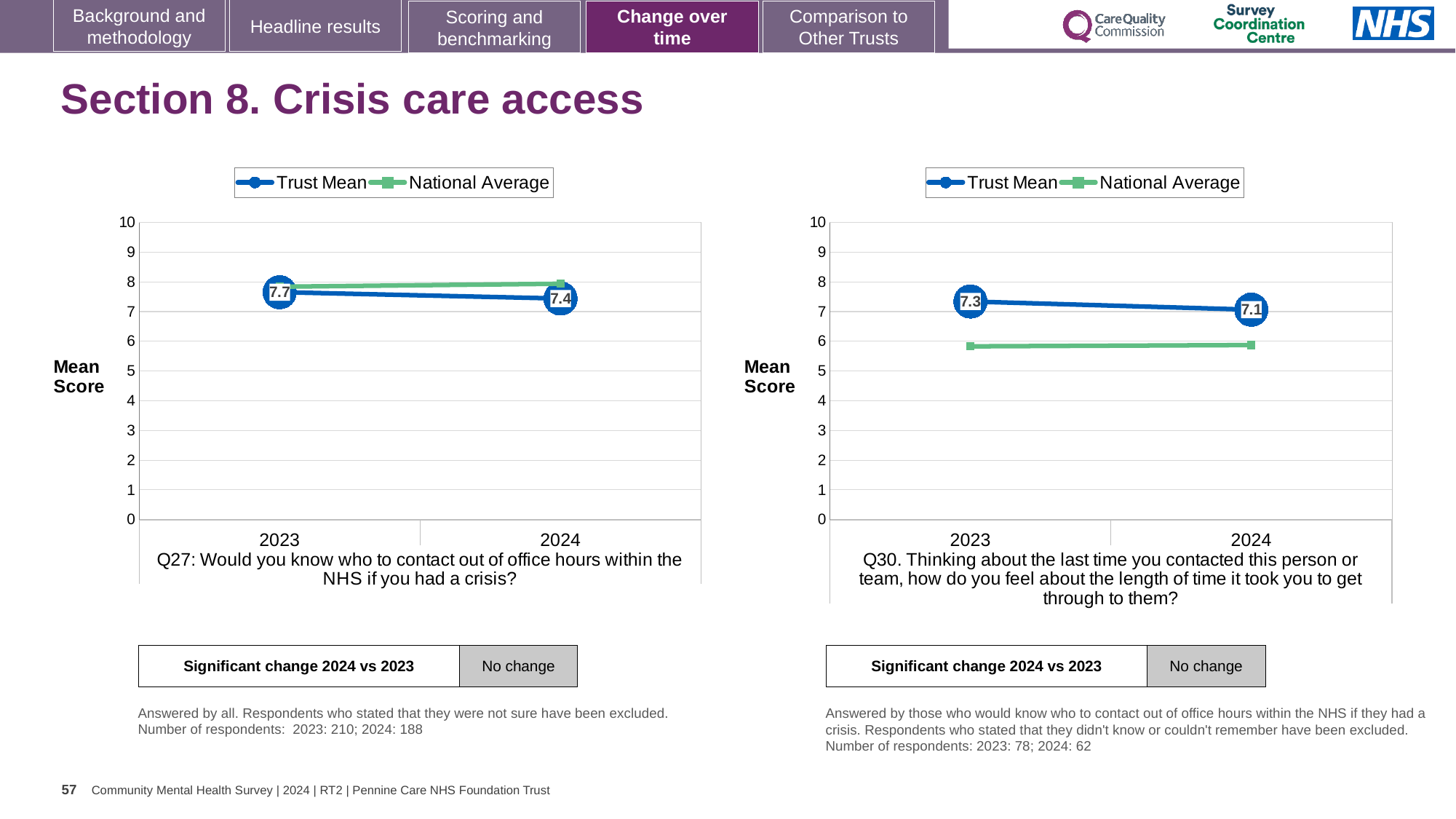
What type of chart is the Q27 chart (left)? line chart On the Q27 chart (left), by how much did the Trust Mean change from 2023 to 2024? 0.3 On the Q30 chart (right), is the National Average for 2023 greater or less than 6? less On the Q30 chart (right), which is higher in 2024, the Trust Mean or the National Average? Trust Mean On the Q30 chart (right), what is the Trust Mean for 2023? 7.3 On the Q27 chart (left), does the Trust Mean rise or fall from 2023 to 2024? fall How many series does the legend of the Q30 chart (right) list? 2 How many years are shown on the x axis of the Q27 chart (left)? 2 On the Q30 chart (right), what is the Trust Mean for 2024? 7.1 On the Q30 chart (right), what is the difference between the Trust Mean in 2023 and 2024? 0.2 On the Q27 chart (left), what is the Trust Mean for 2023? 7.7 On the Q27 chart (left), what is the Trust Mean for 2024? 7.4